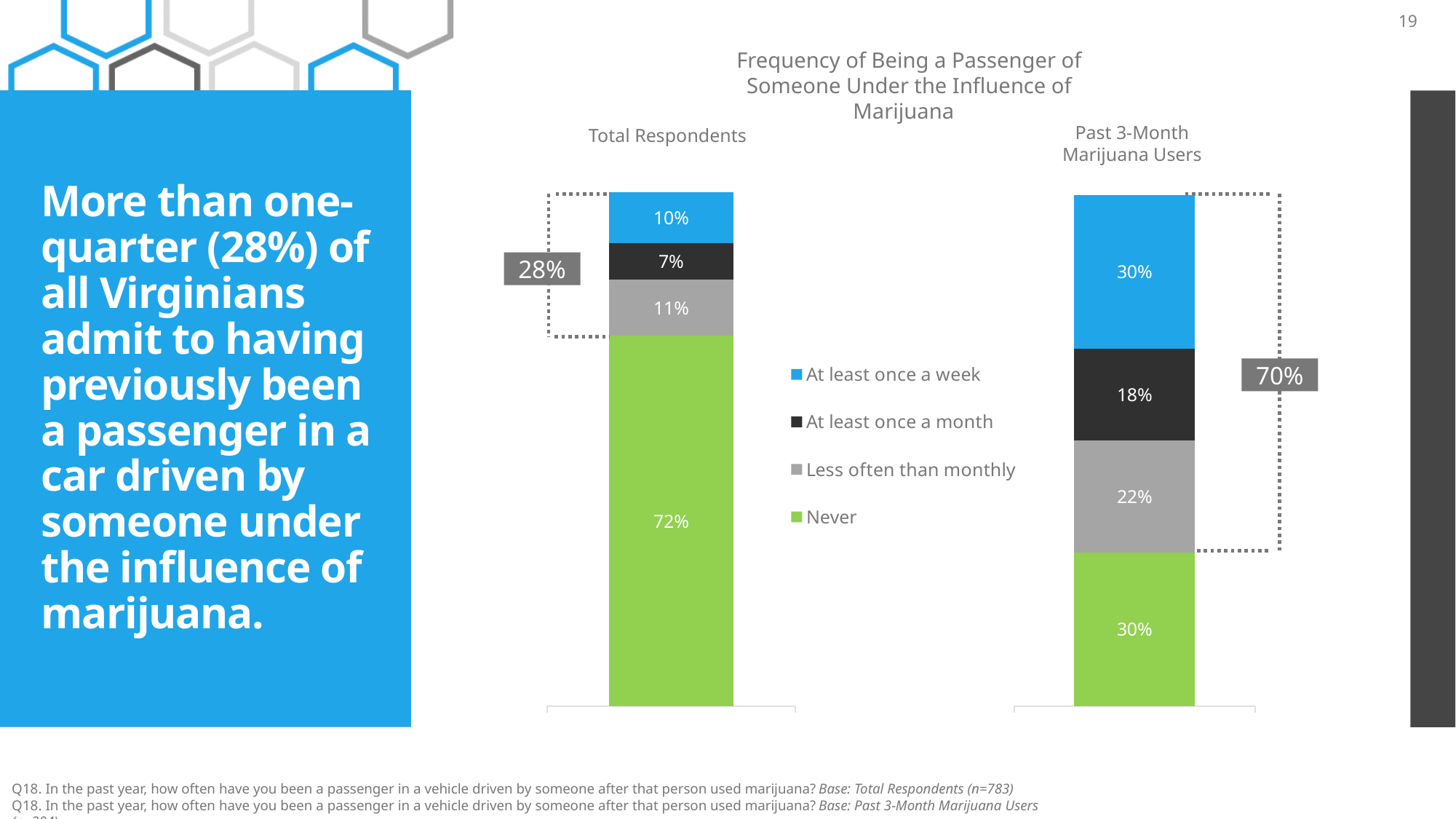
How many series does the legend list? 4 What is the value for "At least once a month" in the Total Respondents bar? 7% How many percentage points higher is the "Never" share for Total Respondents than for Past 3-Month Marijuana Users? 42 percentage points What combined percentage of Past 3-Month Marijuana Users reported being a passenger at least once a week, at least once a month, or less often than monthly? 70% How many stacked bars are shown on the slide? 2 What percentage of Total Respondents answered "Never"? 72% What percentage of Past 3-Month Marijuana Users answered "At least once a week"? 30% Which frequency category is the smallest segment in the Total Respondents bar? At least once a month Which group has the larger "At least once a month" share, Total Respondents or Past 3-Month Marijuana Users? Past 3-Month Marijuana Users Which frequency category is the largest segment in the Total Respondents bar? Never What kind of chart is shown on the slide? Stacked bar chart What is the value for "Less often than monthly" in the Past 3-Month Marijuana Users bar? 22%